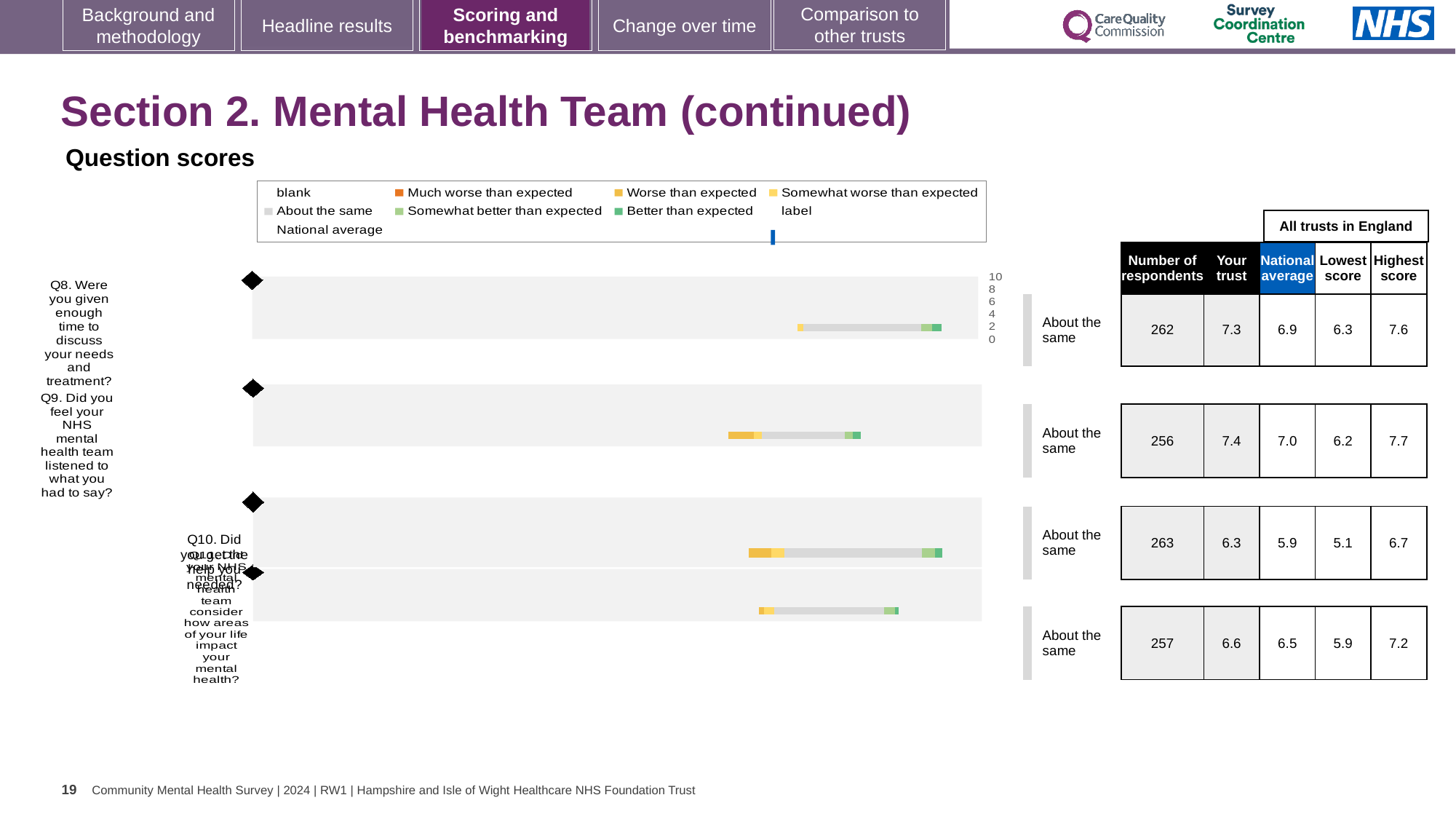
What type of chart is used to show the question scores? Bar chart How many questions are plotted in the chart? 4 Which question has the highest 'Your trust' score? Q9 How many respondents answered Q10 (Did you get the help you needed?)? 263 Which is larger for Q11: the 'Your trust' score or the national average? Your trust What benchmark category is shown for Q9 next to the chart? About the same What is the 'Your trust' score for Q8 (Were you given enough time to discuss your needs and treatment?)? 7.3 What is the difference between the 'Your trust' score and the national average for Q8? 0.4 What is the national average score for Q9 (Did you feel your NHS mental health team listened to what you had to say?)? 7.0 What is the highest score among all trusts in England for Q11 (Did your NHS mental health team consider how areas of your life impact your mental health?)? 7.2 What is the lowest score among all trusts in England for Q10? 5.1 Which question has the lowest 'Your trust' score? Q10